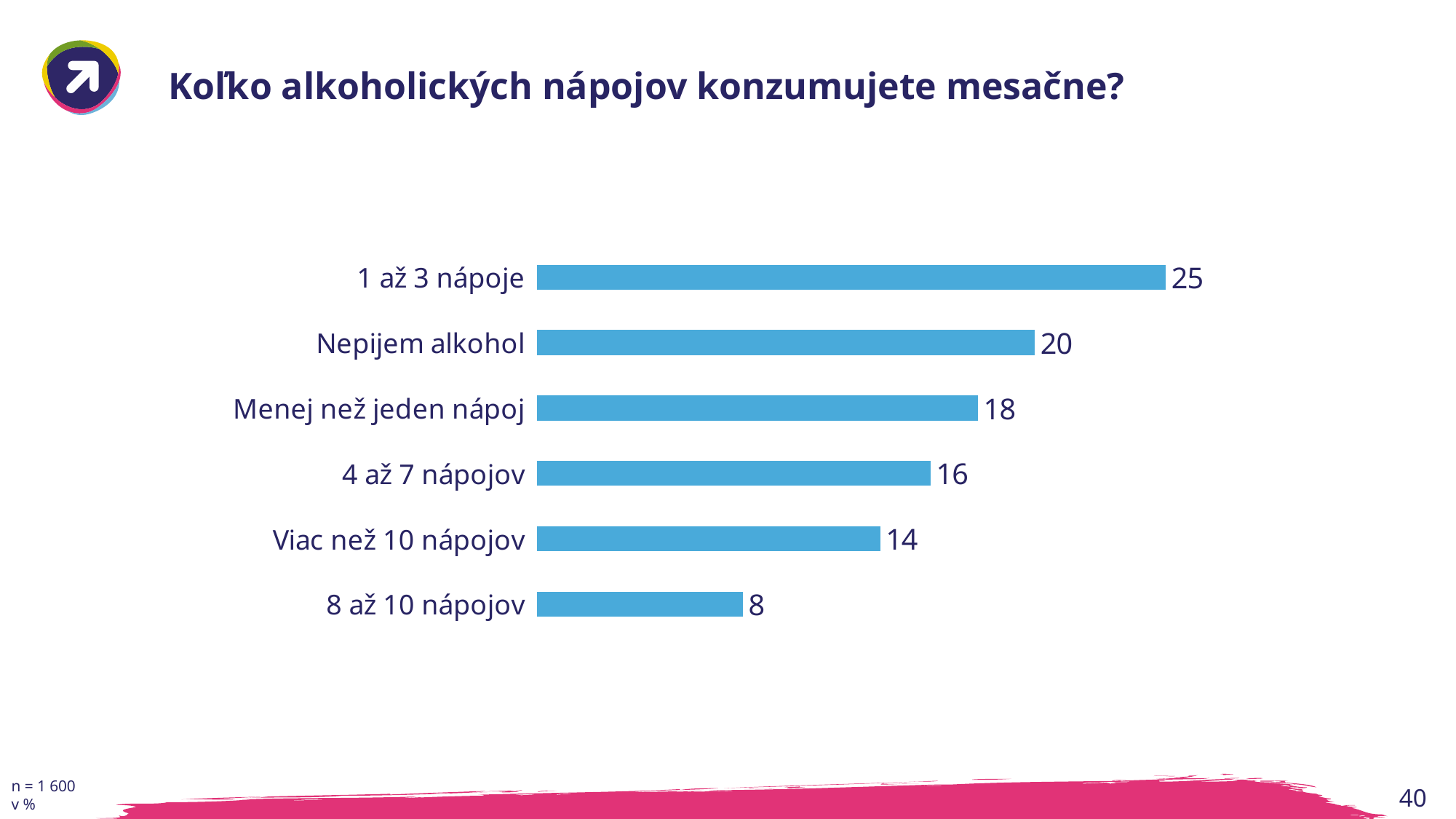
What is the difference between the values for "4 až 7 nápojov" and "8 až 10 nápojov"? 8 Which is larger, the value for "Viac než 10 nápojov" or the value for "8 až 10 nápojov"? Viac než 10 nápojov What is the value for "8 až 10 nápojov"? 8 Which category has the lowest value? 8 až 10 nápojov Which category has the highest value? 1 až 3 nápoje What is the difference between the values for "1 až 3 nápoje" and "Nepijem alkohol"? 5 What is the value for "Menej než jeden nápoj"? 18 What is the title of the slide? Koľko alkoholických nápojov konzumujete mesačne? What is the value for "Nepijem alkohol"? 20 How many categories are shown in the chart? 6 What kind of chart is shown on the slide? Bar chart What is the value for "1 až 3 nápoje"? 25